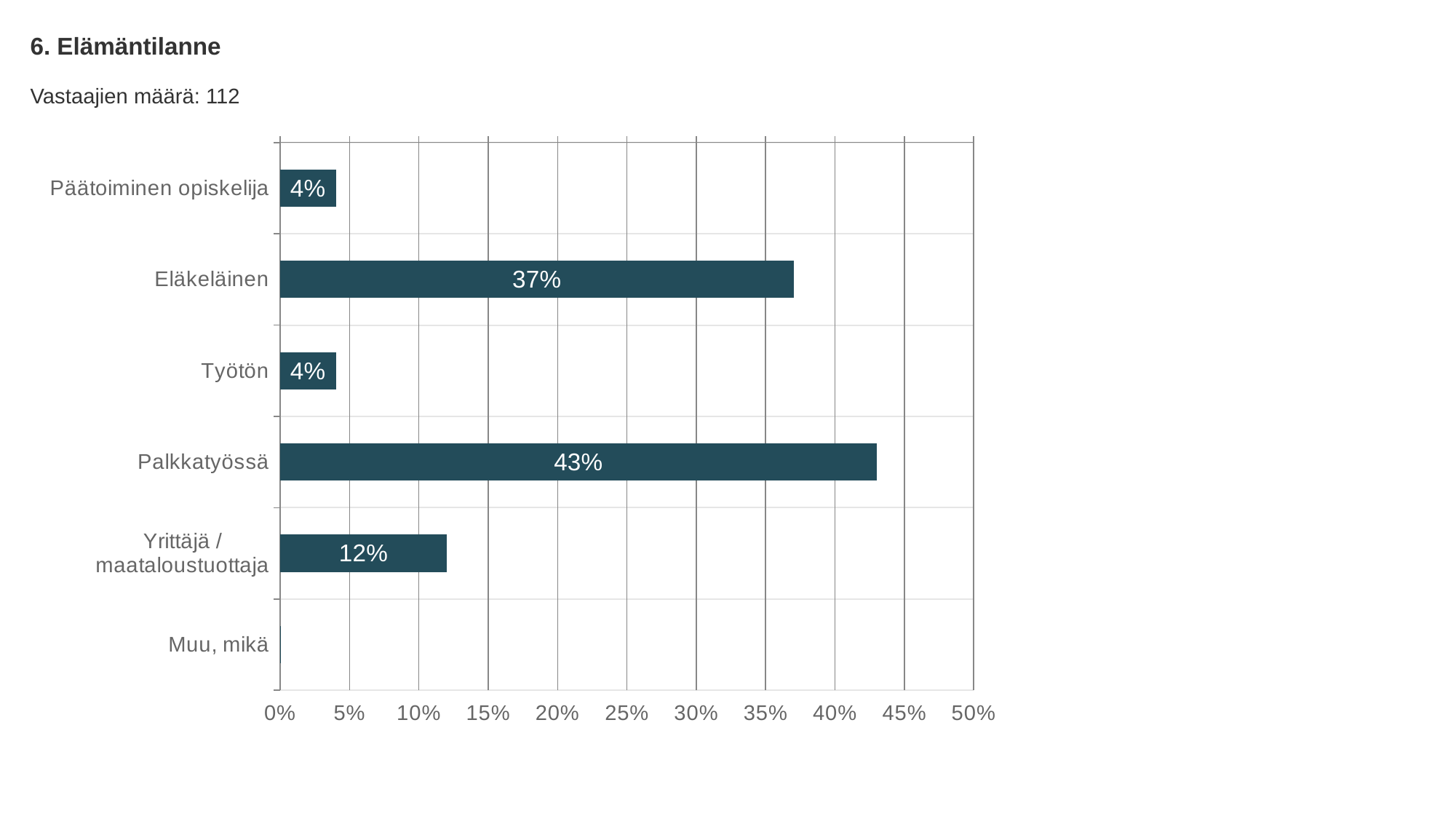
What is the difference between the values for Yrittäjä / maataloustuottaja and Päätoiminen opiskelija? 8% Which category has the highest value? Palkkatyössä What is the title of the chart? 6. Elämäntilanne What is the value for Eläkeläinen? 37% What is the value for Työtön? 4% Which category has the lowest value? Muu, mikä Which is larger, the value for Eläkeläinen or the value for Yrittäjä / maataloustuottaja? Eläkeläinen How many categories are shown on the chart? 6 What is the value for Palkkatyössä? 43% What kind of chart is shown on the slide? Bar chart What is the value for Yrittäjä / maataloustuottaja? 12% What is the difference between the values for Palkkatyössä and Eläkeläinen? 6%